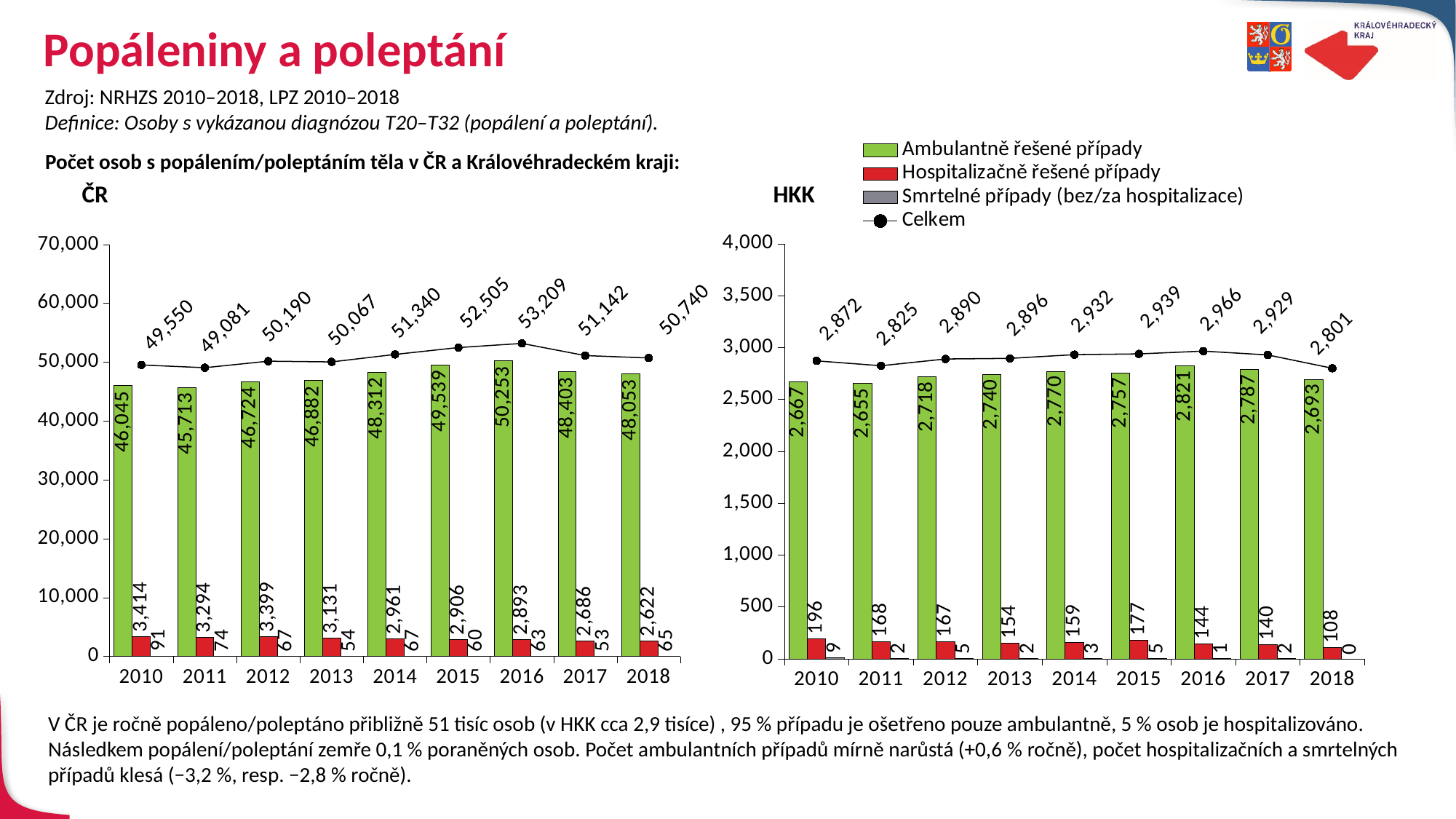
In the HKK chart, what is the Celkem value for 2016? 2,966 In the HKK chart, which year has the lowest Celkem value? 2018 In the ČR chart, what is the value of Ambulantně řešené případy for 2016? 50,253 In the HKK chart, what is the value of Hospitalizačně řešené případy for 2018? 108 In the HKK chart, which is larger: Ambulantně řešené případy in 2013 or in 2017? 2017 How many series does the legend list? 4 In the ČR chart, which year has the highest Celkem value? 2016 In the ČR chart, is the Ambulantně řešené případy value for 2015 greater or less than 40,000? greater What kind of chart is the ČR chart? Bar chart with a line In the ČR chart, what is the difference between the Hospitalizačně řešené případy values for 2010 and 2018? 792 How many years are shown on the x axis of the HKK chart? 9 In the ČR chart, what is the Celkem value for 2014? 51,340